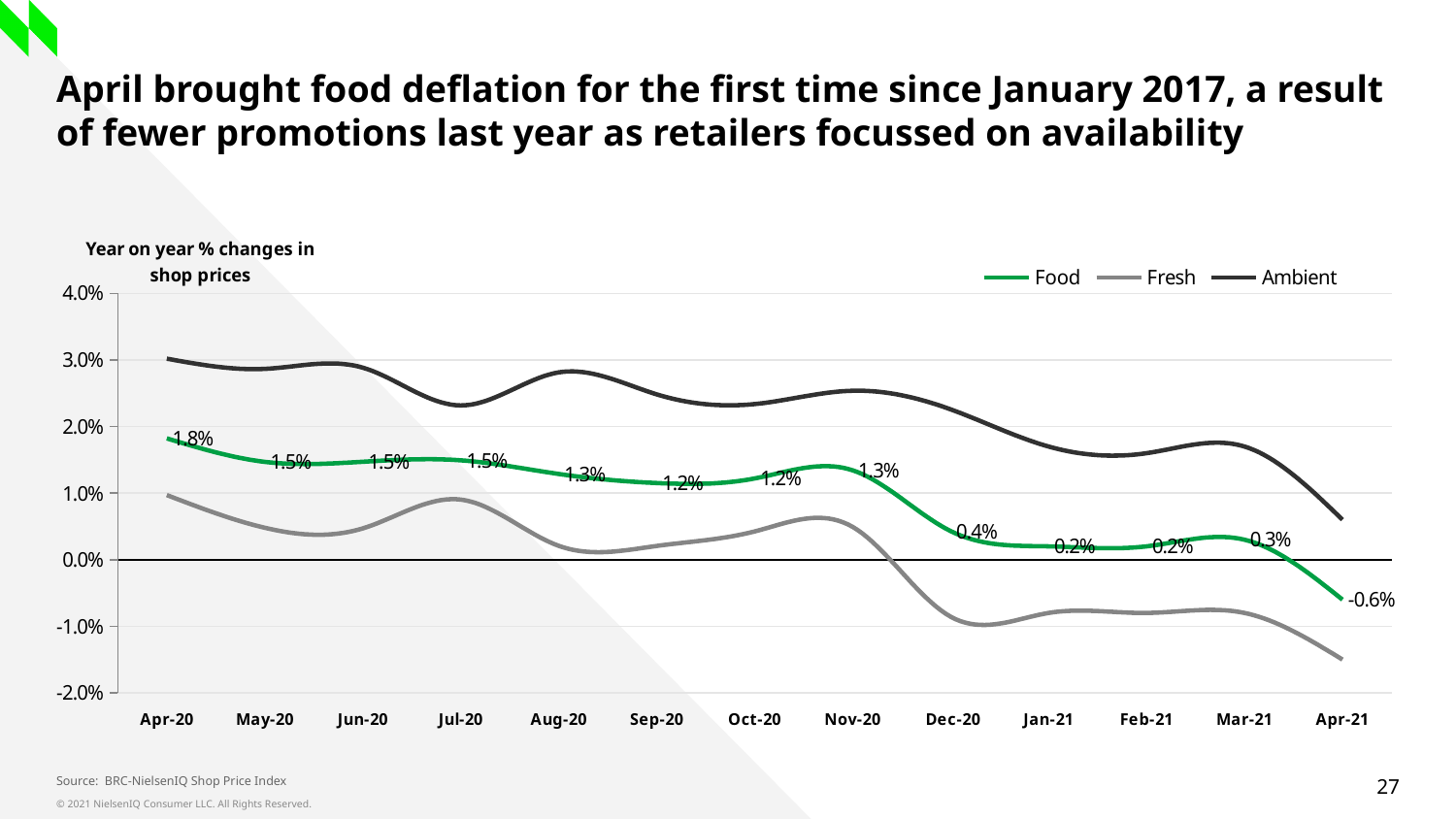
What is the Food value for Apr-21? -0.6% Is the Ambient value for Apr-20 greater or less than 2.0%? greater What is the Food value for Dec-20? 0.4% What kind of chart is shown on the slide? Line chart Which is larger for the Food series, the Nov-20 value or the Dec-20 value? Nov-20 Is the Fresh value for Dec-20 greater or less than 0.0%? less What is the Food value for Apr-20? 1.8% How many months are plotted on the x axis? 13 How many series does the legend list? 3 In which month is the Food series lowest? Apr-21 In which month is the Food series highest? Apr-20 What is the difference between the Food value in Apr-20 and in Apr-21? 2.4 percentage points